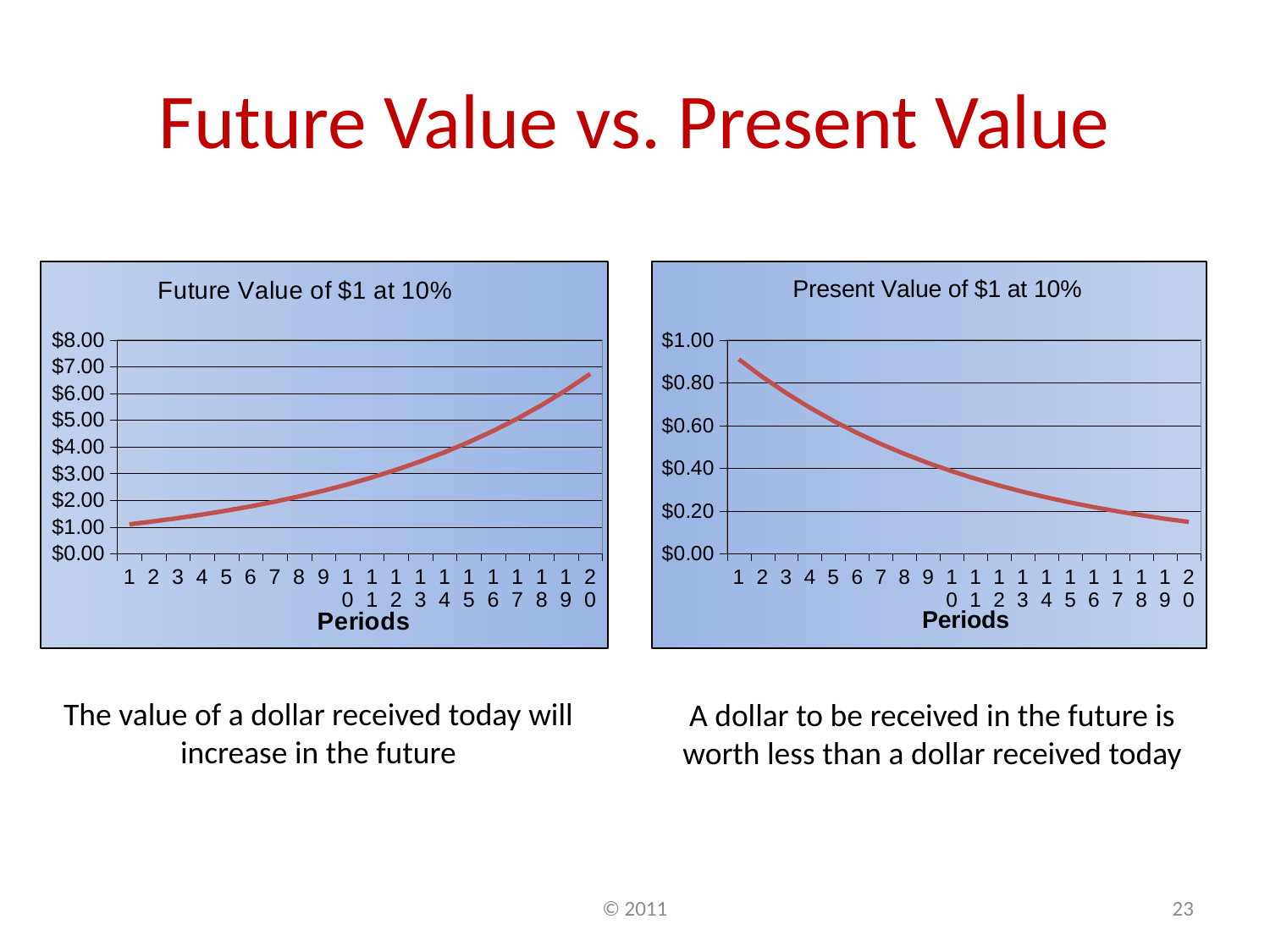
In the "Present Value of $1 at 10%" chart, is the value at period 1 greater or less than $0.80? greater In the "Future Value of $1 at 10%" chart, is the value at period 20 greater or less than $6.00? greater What kind of chart is the "Present Value of $1 at 10%" chart? line chart What kind of chart is the "Future Value of $1 at 10%" chart? line chart How many periods are plotted on the x axis of the "Future Value of $1 at 10%" chart? 20 In the "Present Value of $1 at 10%" chart, is the value at period 20 greater or less than $0.20? less How many periods are plotted on the x axis of the "Present Value of $1 at 10%" chart? 20 In the "Future Value of $1 at 10%" chart, do the values rise or fall as the periods increase? rise What is the x-axis label on the "Future Value of $1 at 10%" chart? Periods In the "Present Value of $1 at 10%" chart, do the values rise or fall as the periods increase? fall In the "Present Value of $1 at 10%" chart, which period has the highest value? 1